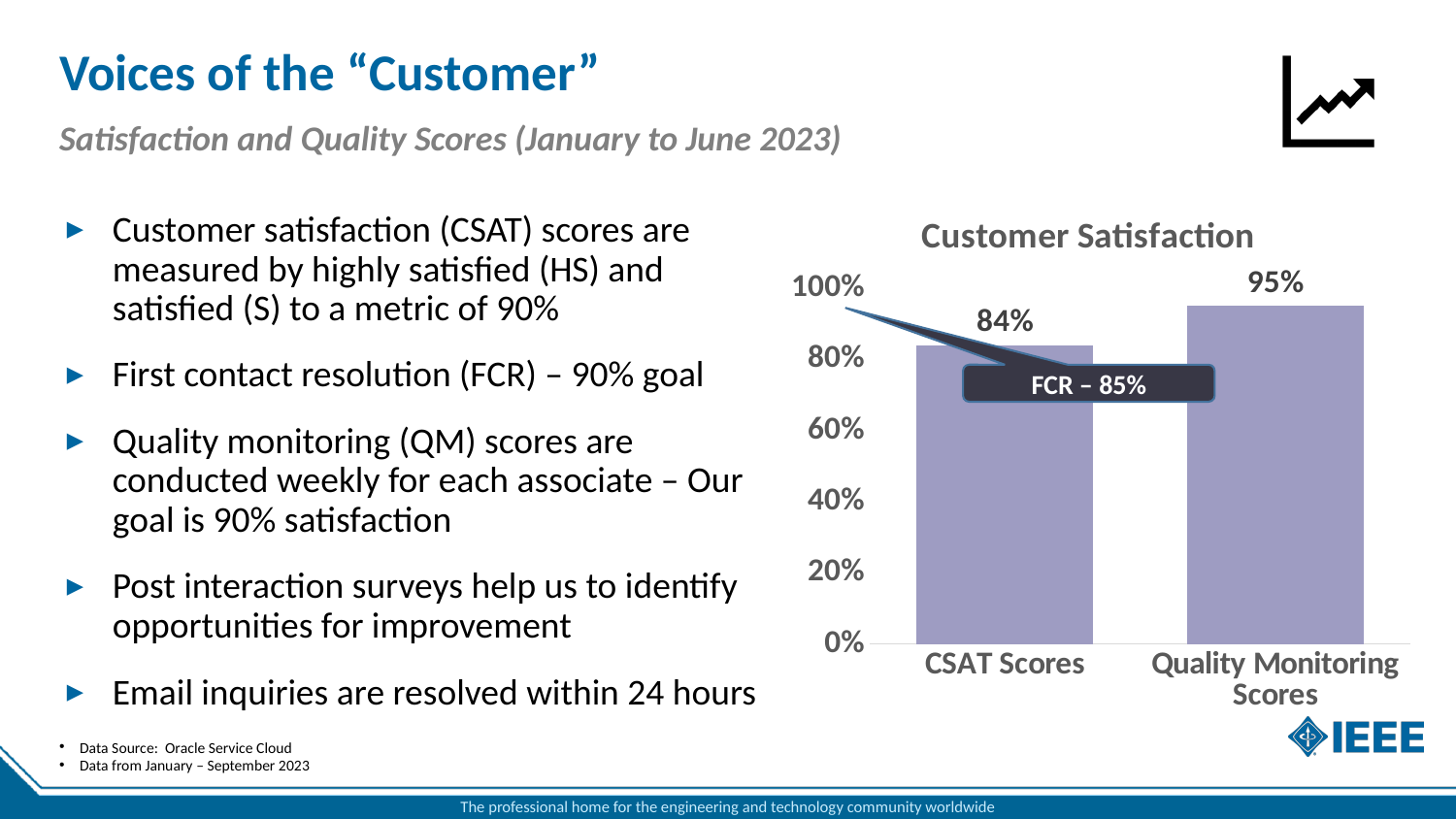
What kind of chart is shown on the slide? Bar chart Which is larger, the CSAT Scores value or the Quality Monitoring Scores value? Quality Monitoring Scores What is the value for Quality Monitoring Scores in the Customer Satisfaction chart? 95% Which category has the highest value in the Customer Satisfaction chart? Quality Monitoring Scores What is the value for CSAT Scores in the Customer Satisfaction chart? 84% What is the title of the chart on the slide? Customer Satisfaction Is the value for Quality Monitoring Scores greater or less than 100%? less What is the difference between the Quality Monitoring Scores value and the CSAT Scores value? 11% What FCR value is shown in the callout on the chart? 85% Which category has the lowest value in the Customer Satisfaction chart? CSAT Scores Is the value for CSAT Scores greater or less than 80%? greater How many categories are shown in the Customer Satisfaction chart? 2